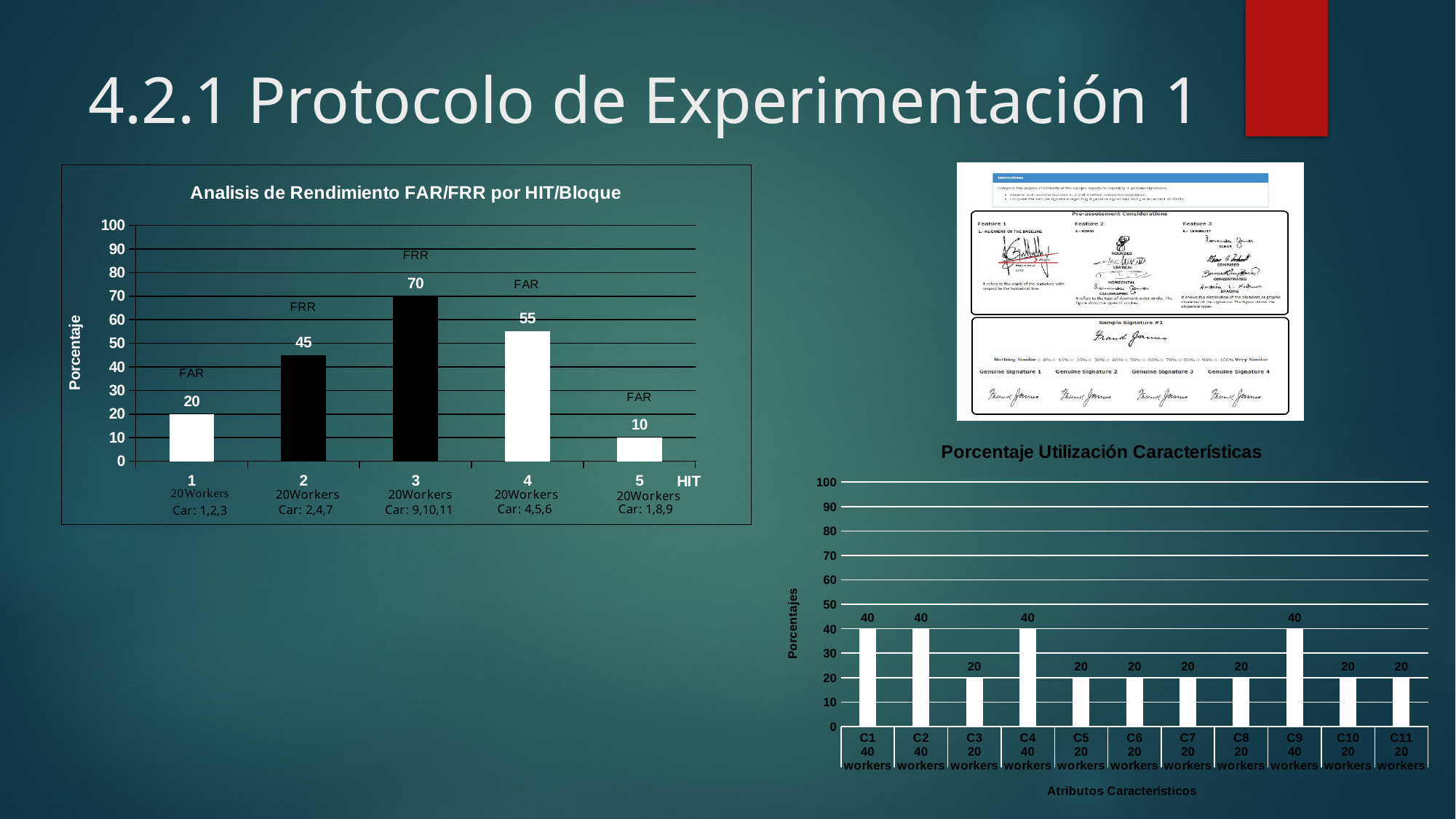
In the chart 'Analisis de Rendimiento FAR/FRR por HIT/Bloque', what is the difference between the values for HIT 3 and HIT 4? 15 In the chart 'Analisis de Rendimiento FAR/FRR por HIT/Bloque', which HIT has the highest value? 3 In the chart 'Analisis de Rendimiento FAR/FRR por HIT/Bloque', what is the value for HIT 3? 70 In the chart 'Analisis de Rendimiento FAR/FRR por HIT/Bloque', which HIT has the lowest value? 5 In the chart 'Porcentaje Utilización Características', what is the value for C9? 40 In the chart 'Analisis de Rendimiento FAR/FRR por HIT/Bloque', how many HIT categories are plotted? 5 In the chart 'Analisis de Rendimiento FAR/FRR por HIT/Bloque', which is larger, the value for HIT 2 or HIT 4? HIT 4 In the chart 'Analisis de Rendimiento FAR/FRR por HIT/Bloque', which label (FAR or FRR) is shown above the bar for HIT 2? FRR In the chart 'Analisis de Rendimiento FAR/FRR por HIT/Bloque', what is the value for HIT 5? 10 In the chart 'Porcentaje Utilización Características', how many categories are plotted? 11 In the chart 'Porcentaje Utilización Características', what is the difference between the values for C1 and C3? 20 What kind of chart is 'Porcentaje Utilización Características'? Bar chart